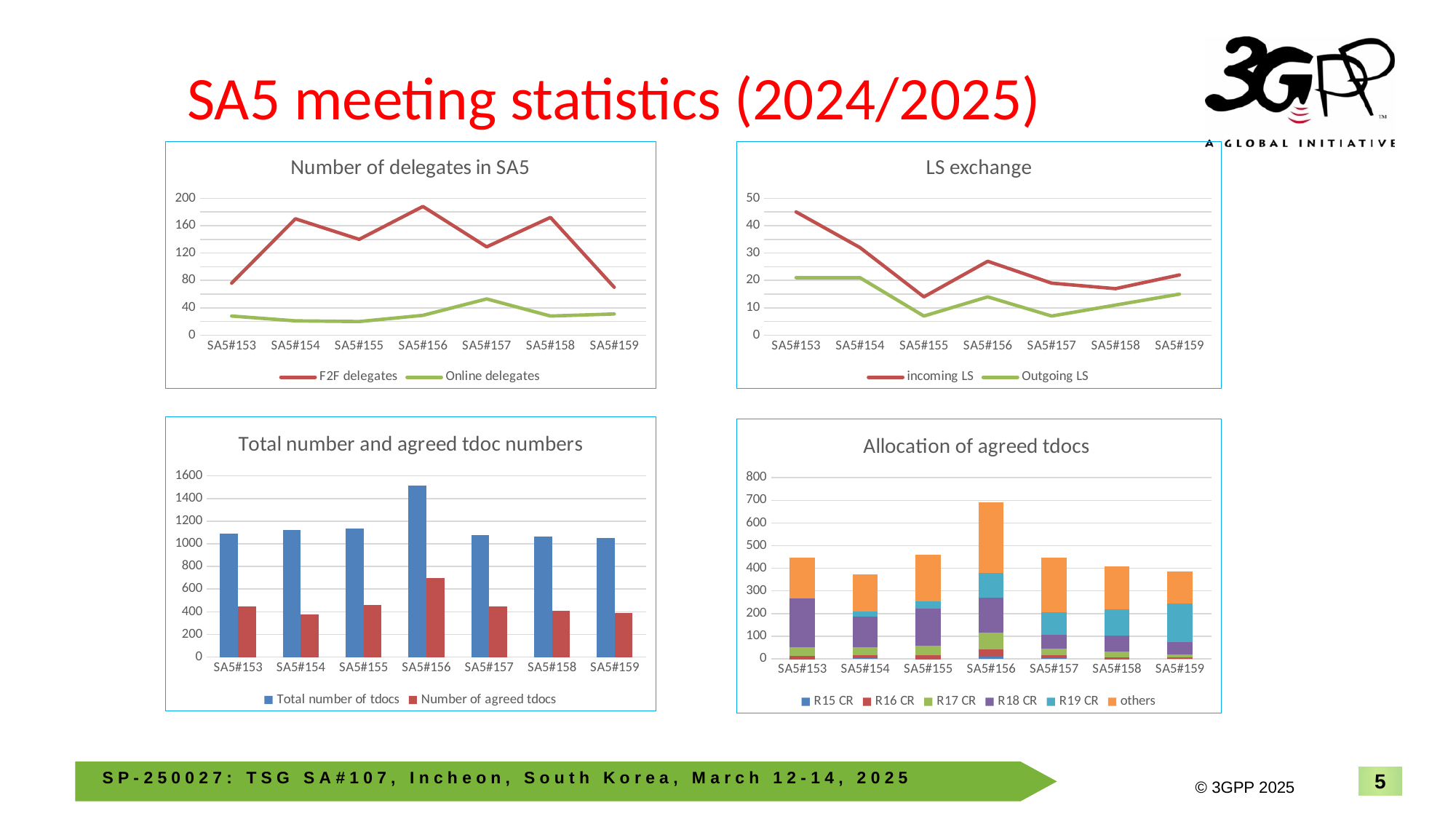
In the 'LS exchange' chart, which is larger at SA5#153: incoming LS or Outgoing LS? incoming LS In the 'Number of delegates in SA5' chart, how many series does the legend list? 2 In the 'Number of delegates in SA5' chart, is the value for F2F delegates at SA5#156 greater or less than 160? greater What kind of chart is 'Total number and agreed tdoc numbers'? bar chart In the 'Number of delegates in SA5' chart, at which meeting is the number of Online delegates highest? SA5#157 In the 'LS exchange' chart, at which meeting is the number of incoming LS highest? SA5#153 In the 'Number of delegates in SA5' chart, at which meeting is the number of F2F delegates highest? SA5#156 In the 'Allocation of agreed tdocs' chart, how many series does the legend list? 6 In the 'LS exchange' chart, is the value for incoming LS at SA5#153 greater or less than 40? greater In the 'Total number and agreed tdoc numbers' chart, is the value for Number of agreed tdocs at SA5#156 greater or less than 600? greater In the 'Allocation of agreed tdocs' chart, how many meetings are shown on the x axis? 7